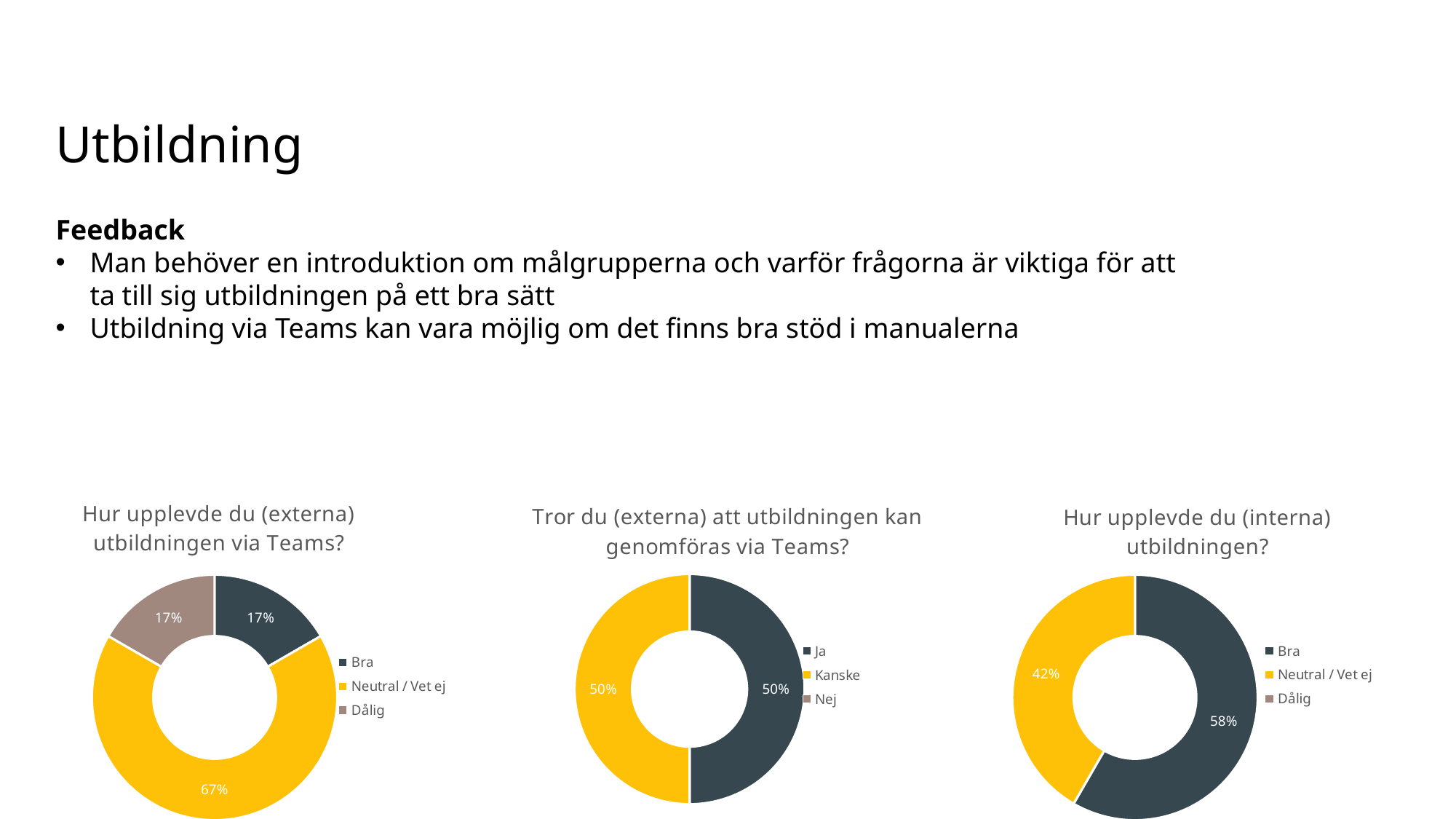
In the chart titled "Tror du (externa) att utbildningen kan genomföras via Teams?", what kind of chart is shown? Doughnut chart In the chart titled "Tror du (externa) att utbildningen kan genomföras via Teams?", what is the difference between the Ja and Kanske shares? 0% In the chart titled "Hur upplevde du (interna) utbildningen?", what is the difference between the Bra and Neutral / Vet ej shares? 16% In the chart titled "Hur upplevde du (externa) utbildningen via Teams?", what share is labelled for Dålig? 17% In the chart titled "Hur upplevde du (interna) utbildningen?", what share is labelled for Neutral / Vet ej? 42% In the chart titled "Hur upplevde du (interna) utbildningen?", which is larger, Bra or Neutral / Vet ej? Bra In the chart titled "Hur upplevde du (externa) utbildningen via Teams?", what share is labelled for Neutral / Vet ej? 67% In the chart titled "Hur upplevde du (interna) utbildningen?", what share is labelled for Bra? 58% In the chart titled "Tror du (externa) att utbildningen kan genomföras via Teams?", what share is labelled for Kanske? 50% In the chart titled "Tror du (externa) att utbildningen kan genomföras via Teams?", what share is labelled for Ja? 50% In the chart titled "Hur upplevde du (externa) utbildningen via Teams?", which category has the largest share? Neutral / Vet ej In the chart titled "Hur upplevde du (externa) utbildningen via Teams?", how many entries does the legend list? 3